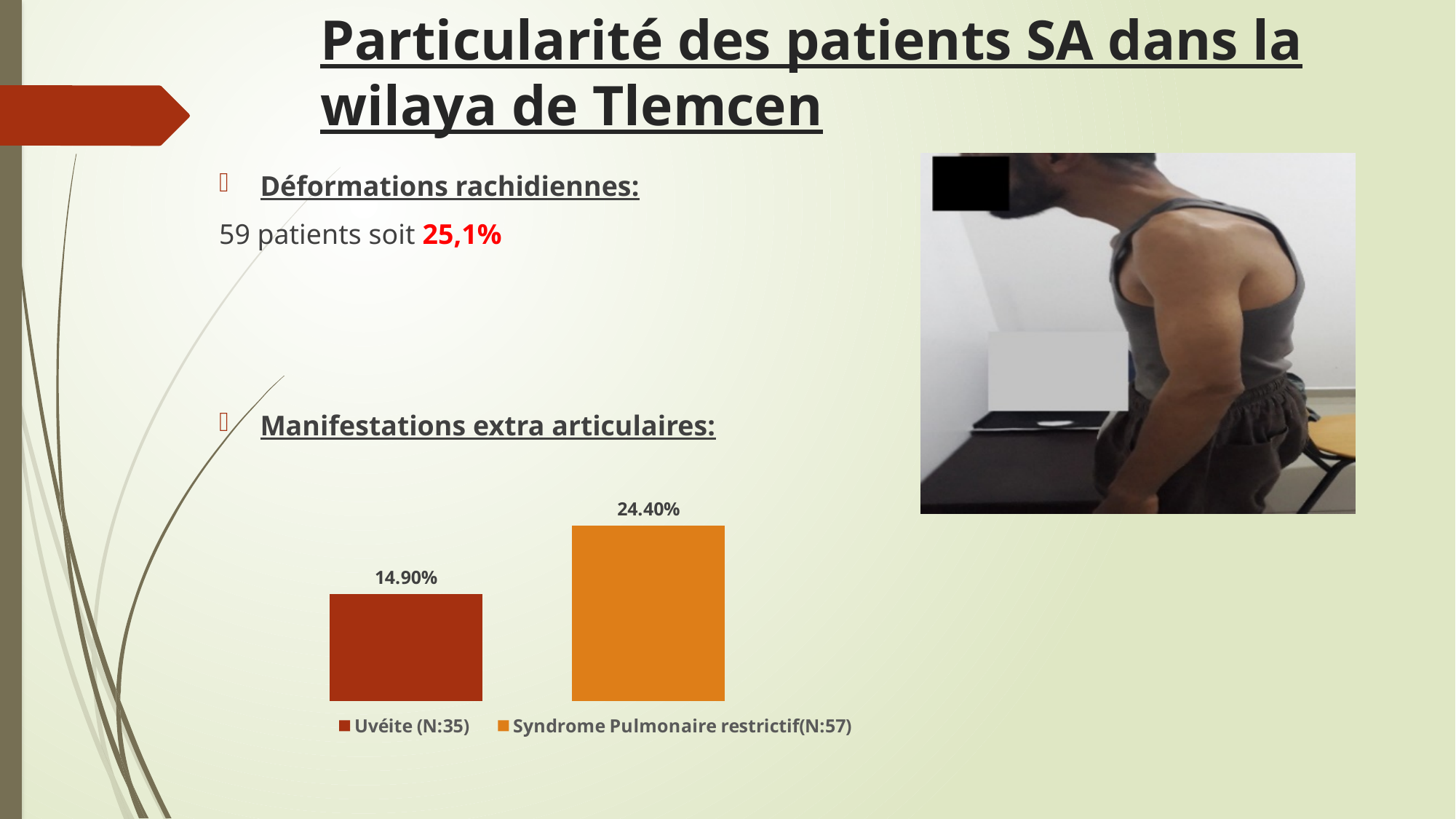
Which series has the highest value in the chart? Syndrome Pulmonaire restrictif(N:57) How many bars are plotted in the chart? 2 Which is larger, the value for Uvéite (N:35) or the value for Syndrome Pulmonaire restrictif(N:57)? Syndrome Pulmonaire restrictif(N:57) What kind of chart is shown on the slide? bar chart What is the difference between the values for Syndrome Pulmonaire restrictif(N:57) and Uvéite (N:35)? 9.50% What colour is the bar for Uvéite (N:35)? dark red What is the value shown for Syndrome Pulmonaire restrictif(N:57)? 24.40% What is the value shown for Uvéite (N:35)? 14.90% How many series does the legend list? 2 Which series has the lowest value in the chart? Uvéite (N:35) What colour is the bar for Syndrome Pulmonaire restrictif(N:57)? orange